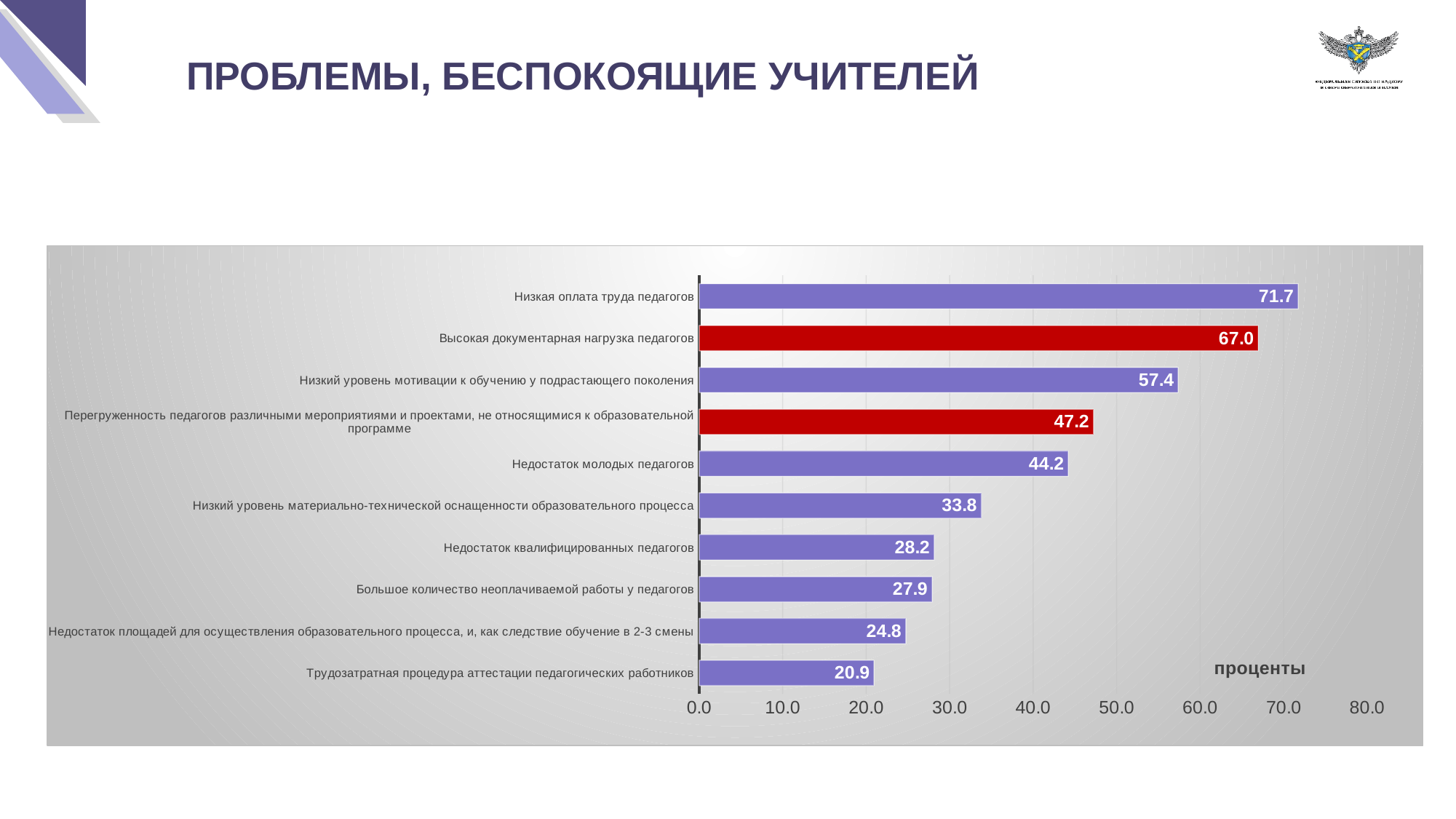
What is the value for "Трудозатратная процедура аттестации педагогических работников"? 20.9 What is the difference between the values for "Низкая оплата труда педагогов" and "Высокая документарная нагрузка педагогов"? 4.7 What is the label shown on the horizontal axis of the chart? проценты What is the value for "Недостаток молодых педагогов"? 44.2 What is the value for "Низкая оплата труда педагогов"? 71.7 Is the value for "Низкий уровень мотивации к обучению у подрастающего поколения" greater or less than 50.0? greater Which category has the highest value? Низкая оплата труда педагогов Which is larger: the value for "Недостаток квалифицированных педагогов" or the value for "Большое количество неоплачиваемой работы у педагогов"? Недостаток квалифицированных педагогов What kind of chart is shown on the slide? bar chart How many categories are shown in the chart? 10 Which two categories are shown with red bars? Высокая документарная нагрузка педагогов; Перегруженность педагогов различными мероприятиями и проектами, не относящимися к образовательной программе Which category has the lowest value? Трудозатратная процедура аттестации педагогических работников